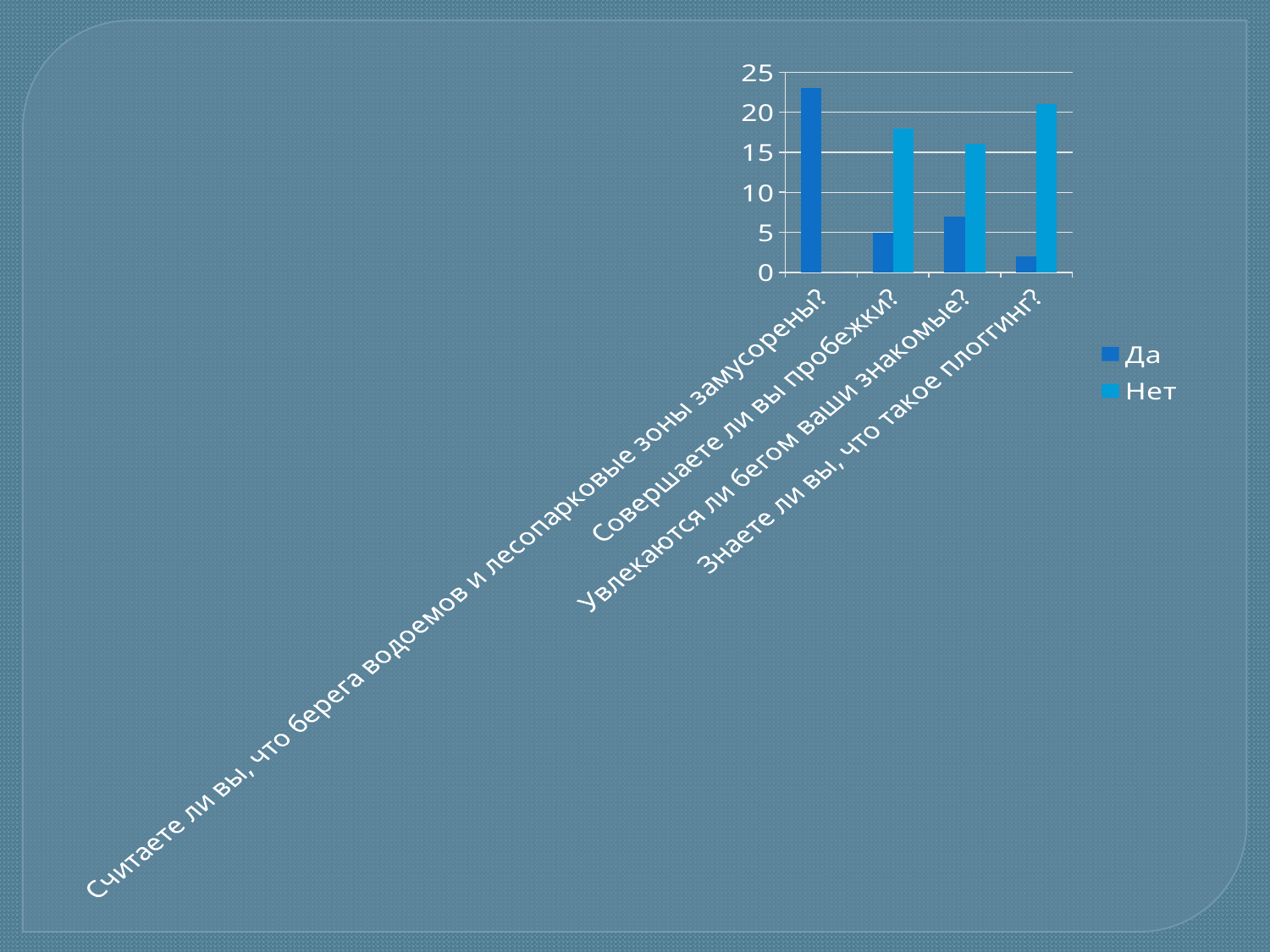
For which question is the 'Да' bar the lowest? Знаете ли вы, что такое плоггинг? What are the two legend entries? Да, Нет How many series does the legend list? 2 For which question is the 'Да' bar the highest? Считаете ли вы, что берега водоемов и лесопарковые зоны замусорены? Is the 'Да' value for 'Считаете ли вы, что берега водоемов и лесопарковые зоны замусорены?' greater or less than 20? greater What kind of chart is shown on the slide? bar chart For 'Совершаете ли вы пробежки?', which is larger, 'Да' or 'Нет'? Нет Is the 'Нет' value for 'Совершаете ли вы пробежки?' greater or less than 20? less For which question is the 'Нет' bar the highest? Знаете ли вы, что такое плоггинг? Is the 'Нет' value for 'Увлекаются ли бегом ваши знакомые?' greater or less than 10? greater How many question categories are shown on the x axis? 4